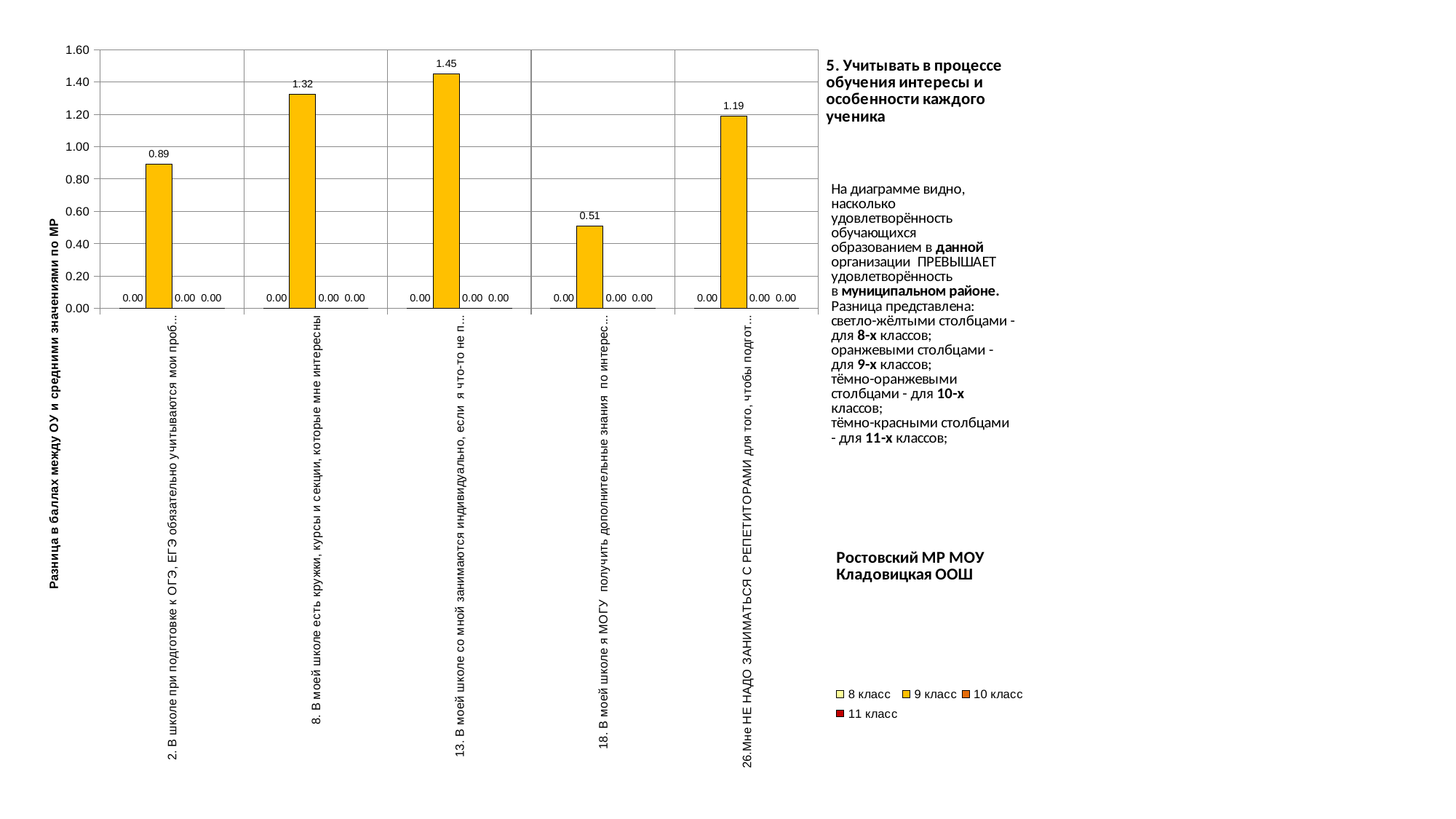
What is the value for 9 класс for question 26 ("Мне НЕ НАДО ЗАНИМАТЬСЯ С РЕПЕТИТОРАМИ...")? 1.19 How many series does the chart legend list? 4 What is the value for 9 класс for question 13 ("В моей школе со мной занимаются индивидуально...")? 1.45 What type of chart is shown on the slide? Bar chart Which question has the lowest value for 9 класс? 18. В моей школе я МОГУ получить дополнительные знания... What is the label of the vertical axis of the chart? Разница в баллах между ОУ и средними значениями по МР What is the difference between the 9 класс values for question 13 and question 18? 0.94 What is the value for 9 класс for question 8 ("В моей школе есть кружки, курсы и секции, которые мне интересны")? 1.32 Which is larger for 9 класс: the value for question 2 or the value for question 26? Question 26 (1.19) Which question has the highest value for 9 класс? 13. В моей школе со мной занимаются индивидуально... How many questions (categories) are shown on the x axis of the chart? 5 What is the value for 8 класс for question 2 ("В школе при подготовке к ОГЭ, ЕГЭ...")? 0.00